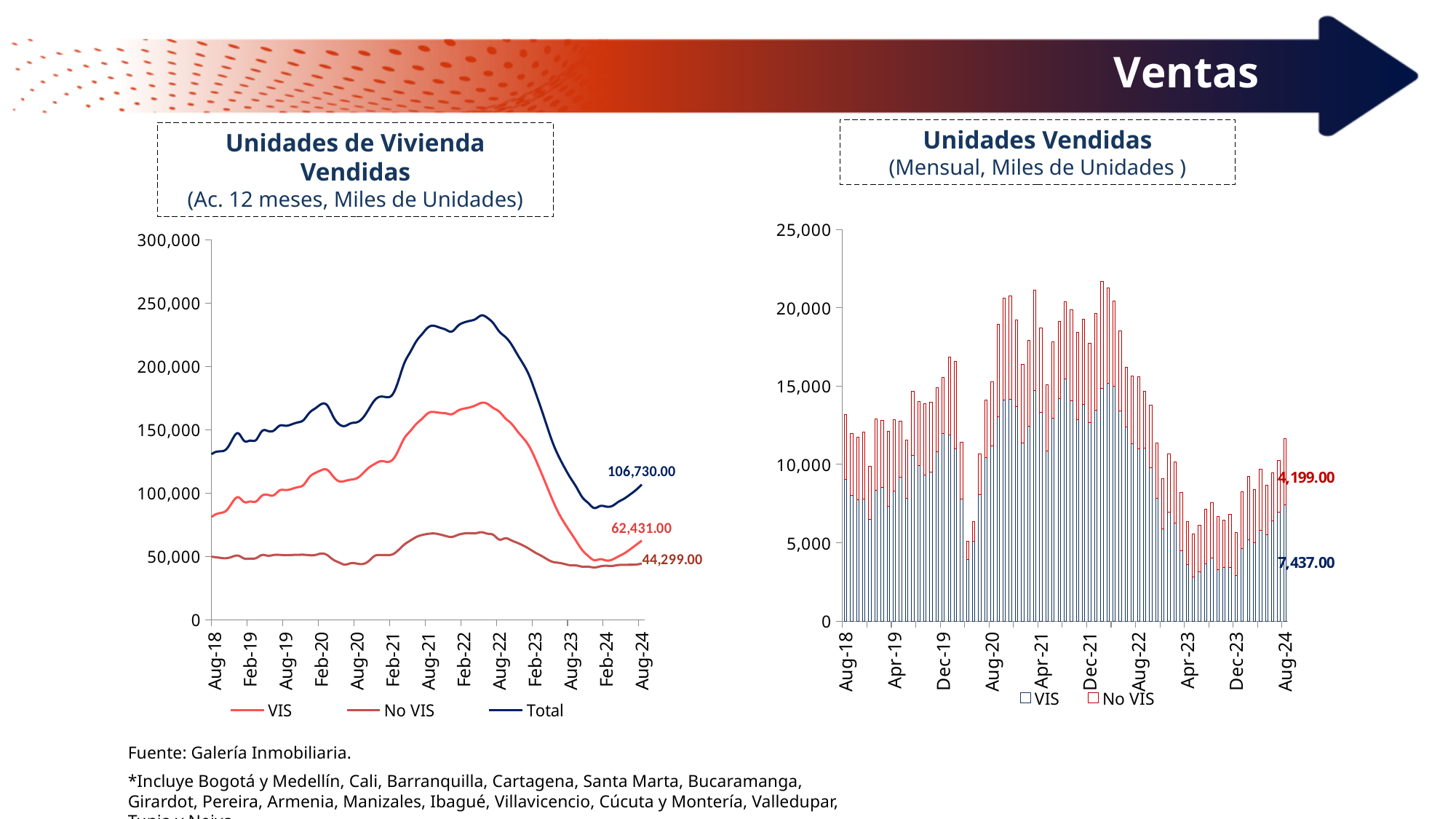
What kind of chart is the left chart, 'Unidades de Vivienda Vendidas'? line chart In the left chart, 'Unidades de Vivienda Vendidas', what is the labelled value of the Total series at Aug-24? 106,730.00 In the right chart, 'Unidades Vendidas (Mensual)', what is the labelled VIS value at Aug-24? 7,437.00 In the left chart, 'Unidades de Vivienda Vendidas', what is the difference between the labelled VIS and No VIS values at Aug-24? 18,132.00 In the right chart, 'Unidades Vendidas (Mensual)', what is the total of the Aug-24 stacked bar (VIS plus No VIS)? 11,636.00 How many series does the legend of the left chart, 'Unidades de Vivienda Vendidas', list? 3 In the left chart, 'Unidades de Vivienda Vendidas', is the Total value at Feb-22 greater or less than 200,000? greater In the left chart, 'Unidades de Vivienda Vendidas', what is the labelled value of the VIS series at Aug-24? 62,431.00 What kind of chart is the right chart, 'Unidades Vendidas (Mensual)'? bar chart In the left chart, 'Unidades de Vivienda Vendidas', what is the labelled value of the No VIS series at Aug-24? 44,299.00 In the left chart, 'Unidades de Vivienda Vendidas', which series has the larger labelled value at Aug-24, VIS or No VIS? VIS In the left chart, 'Unidades de Vivienda Vendidas', does the Total series rise or fall between Aug-22 and Aug-23? fall